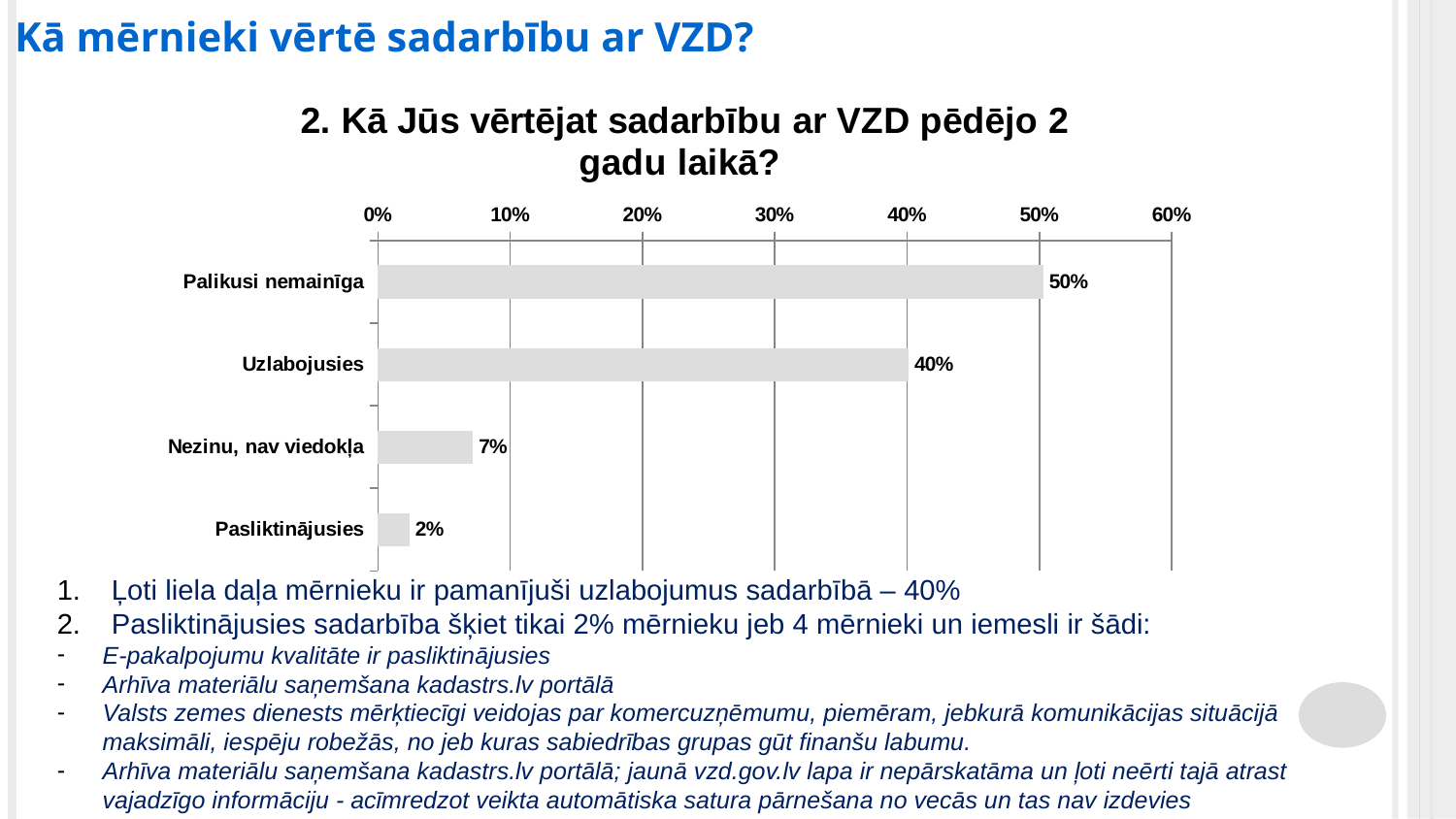
What is the difference between the values for "Palikusi nemainīga" and "Uzlabojusies"? 10% Which category has the lowest value? Pasliktinājusies What is the value for "Pasliktinājusies"? 2% What is the value for "Palikusi nemainīga"? 50% Which is larger, the value for "Uzlabojusies" or the value for "Nezinu, nav viedokļa"? Uzlabojusies How many categories are shown in the chart? 4 What is the difference between the values for "Nezinu, nav viedokļa" and "Pasliktinājusies"? 5% What is the value for "Nezinu, nav viedokļa"? 7% What kind of chart is shown on the slide? Bar chart What is the title of the chart? 2. Kā Jūs vērtējat sadarbību ar VZD pēdējo 2 gadu laikā? What is the value for "Uzlabojusies"? 40% Which category has the highest value? Palikusi nemainīga